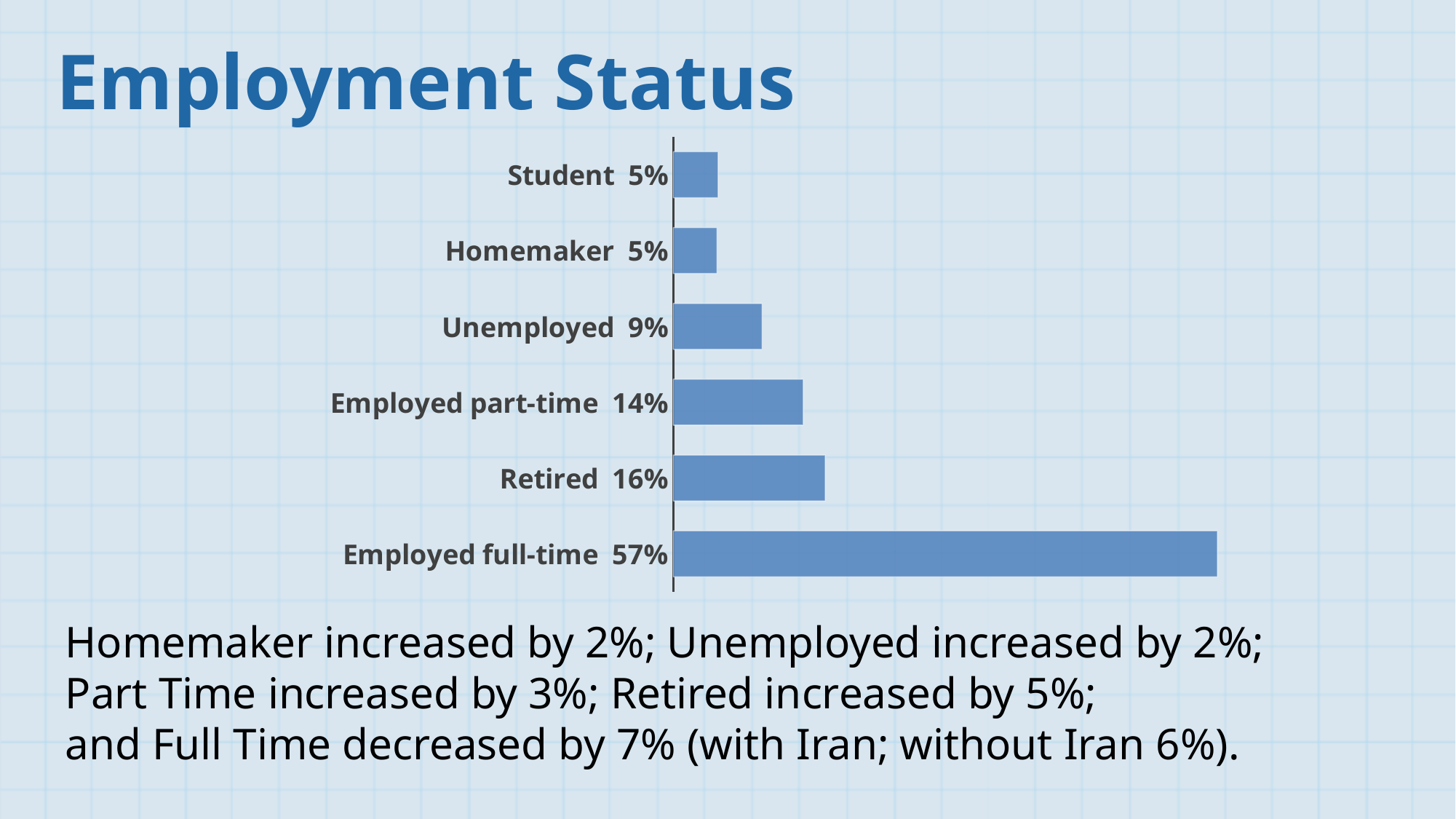
Which category has the highest value? Employed full-time What is the title of the slide? Employment Status How many categories are shown in the chart? 6 What is the difference between Employed full-time and Retired? 41% Which is larger, Unemployed or Employed part-time? Employed part-time What is the difference between Retired and Employed part-time? 2% What is the combined value of Student and Homemaker? 10% What is the value for Retired? 16% What is the value for Employed full-time? 57% What kind of chart is shown on the slide? Bar chart What is the value for Unemployed? 9% What is the value for Employed part-time? 14%